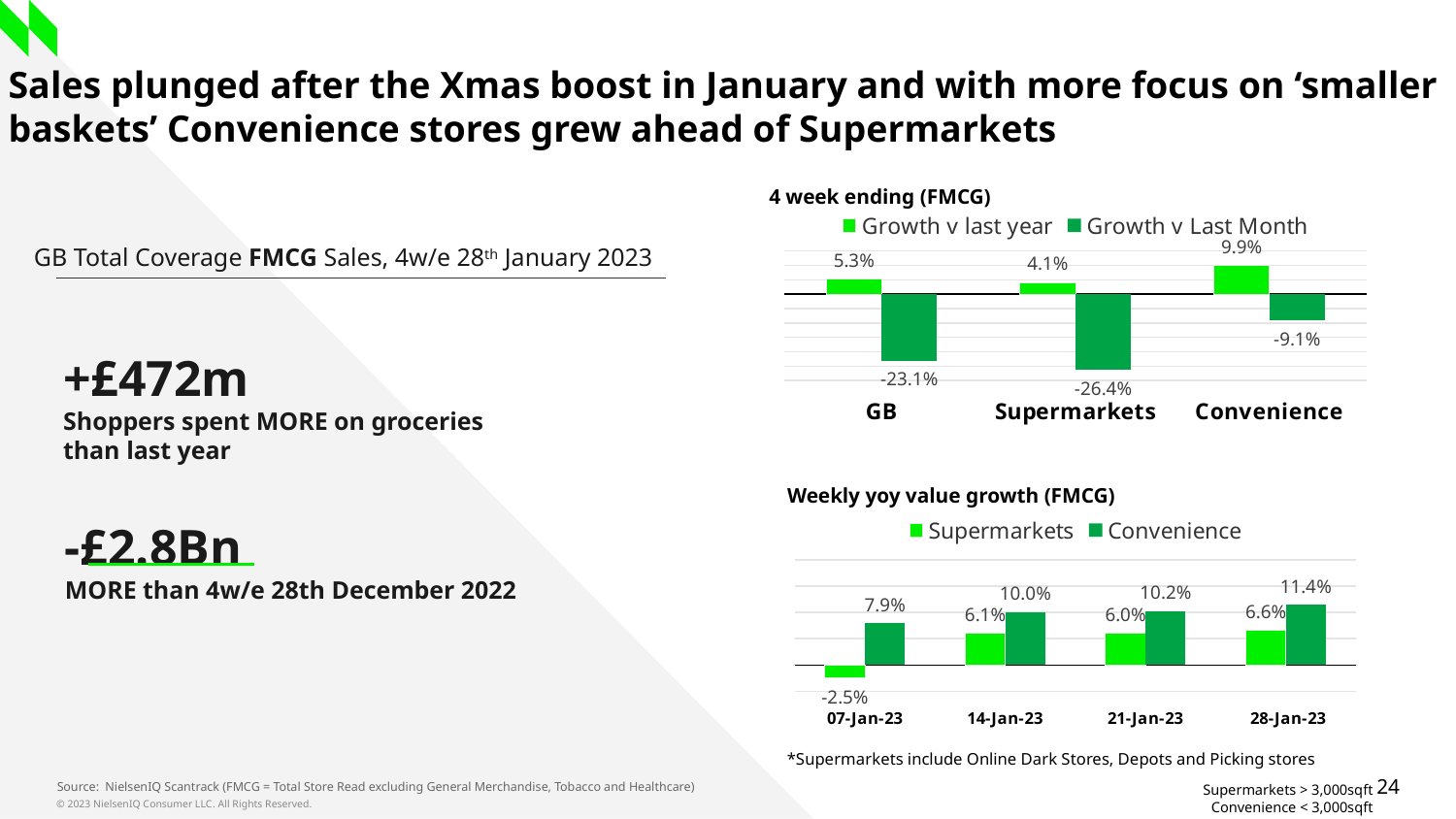
What kind of chart is the 'Weekly yoy value growth (FMCG)' chart? Bar chart In the '4 week ending (FMCG)' chart, what is the Growth v last year value for Convenience? 9.9% In the 'Weekly yoy value growth (FMCG)' chart, how many weeks are shown on the x axis? 4 In the '4 week ending (FMCG)' chart, which category has the lowest Growth v Last Month? Supermarkets In the 'Weekly yoy value growth (FMCG)' chart, what is the Convenience value for 28-Jan-23? 11.4% In the '4 week ending (FMCG)' chart, how many series does the legend list? 2 In the 'Weekly yoy value growth (FMCG)' chart, what is the Supermarkets value for 07-Jan-23? -2.5% In the 'Weekly yoy value growth (FMCG)' chart, is the Convenience value or the Supermarkets value larger for 21-Jan-23? Convenience In the '4 week ending (FMCG)' chart, which category has the highest Growth v last year? Convenience In the '4 week ending (FMCG)' chart, what is the difference between the Growth v last year values for Convenience and Supermarkets? 5.8 percentage points In the '4 week ending (FMCG)' chart, what is the Growth v Last Month value for Supermarkets? -26.4% In the 'Weekly yoy value growth (FMCG)' chart, which week has the highest Convenience value? 28-Jan-23